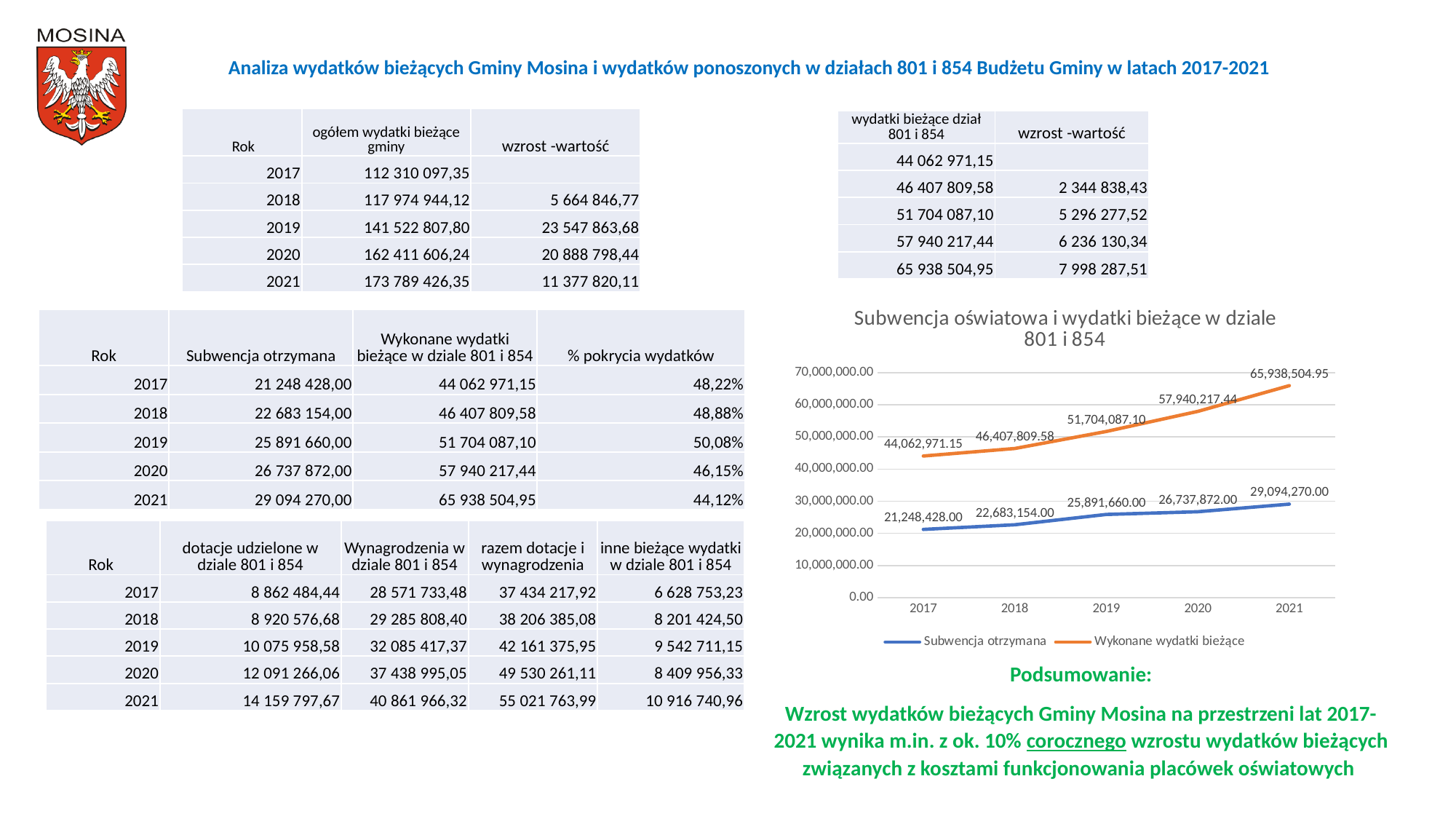
In which year is Wykonane wydatki bieżące highest on the chart? 2021 Does Subwencja otrzymana rise or fall from 2017 to 2021 on the chart? rise What is the difference between Wykonane wydatki bieżące and Subwencja otrzymana in 2017 on the chart? 22,814,543.15 What is the chart's title? Subwencja oświatowa i wydatki bieżące w dziale 801 i 854 What kind of chart is shown on the slide? line chart How many years are plotted along the x axis of the chart? 5 Which is larger in 2020 on the chart: Subwencja otrzymana or Wykonane wydatki bieżące? Wykonane wydatki bieżące What is the value of Wykonane wydatki bieżące in 2019 on the chart? 51,704,087.10 How many series does the chart's legend list? 2 What is the value of Subwencja otrzymana in 2021 on the chart? 29,094,270.00 Which colour is the Subwencja otrzymana line on the chart? blue In which year is Subwencja otrzymana lowest on the chart? 2017